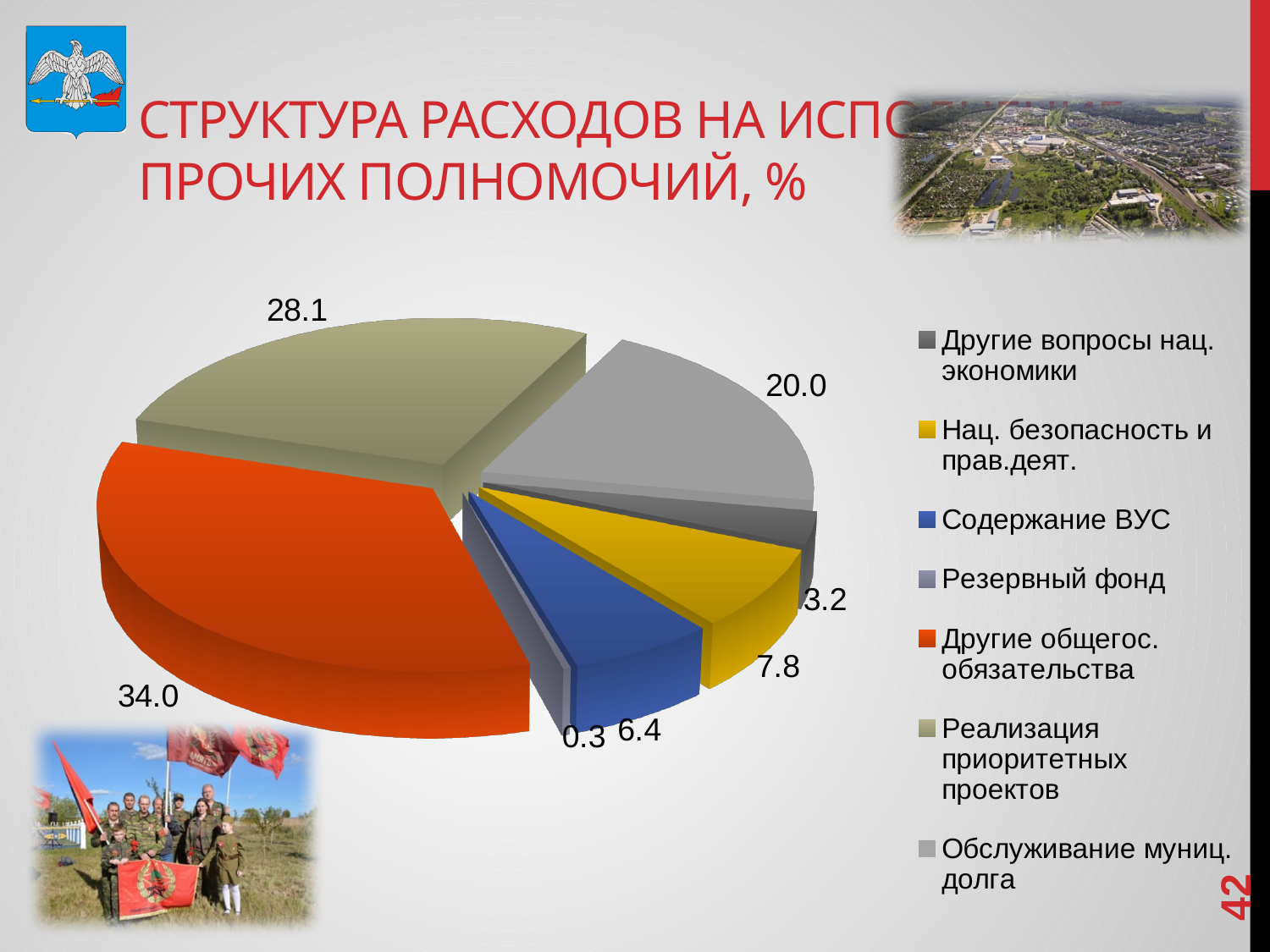
What is the value for Содержание ВУС? 6.4 Which category has the largest slice of the pie? Другие общегос. обязательства Which is larger: Нац. безопасность и прав.деят. or Содержание ВУС? Нац. безопасность и прав.деят. How many categories does the legend list? 7 What is the smallest value labelled on the pie chart? 0.3 What is the difference between the values for Другие общегос. обязательства and Реализация приоритетных проектов? 5.9 What kind of chart is shown on the slide? pie chart What is the value for Другие вопросы нац. экономики? 3.2 What is the value for Нац. безопасность и прав.деят.? 7.8 What colour is the slice for Содержание ВУС? blue What is the value for Реализация приоритетных проектов? 28.1 What is the value for Другие общегос. обязательства? 34.0